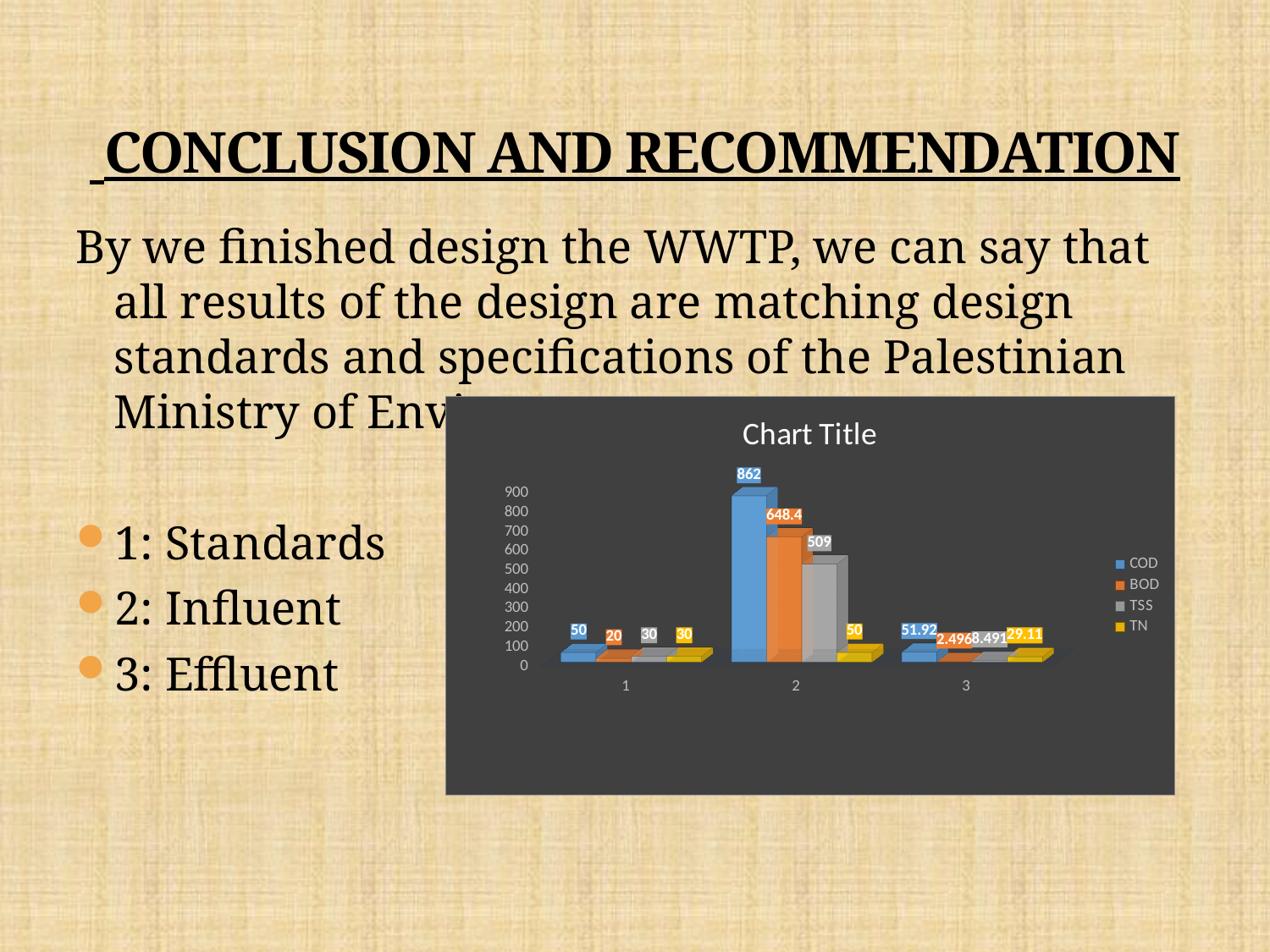
For category 1, which is larger, COD or BOD? COD How many categories are shown on the x axis? 3 What is the value of COD for category 3? 51.92 What is the value of TSS for category 2? 509 What is the value of TN for category 3? 29.11 What is the value of COD for category 2? 862 How many series does the legend list? 4 What is the value of BOD for category 2? 648.4 Which category has the highest COD value? 2 What is the value of TN for category 1? 30 What kind of chart is shown on the slide? bar chart What is the difference between the COD and TSS values for category 2? 353